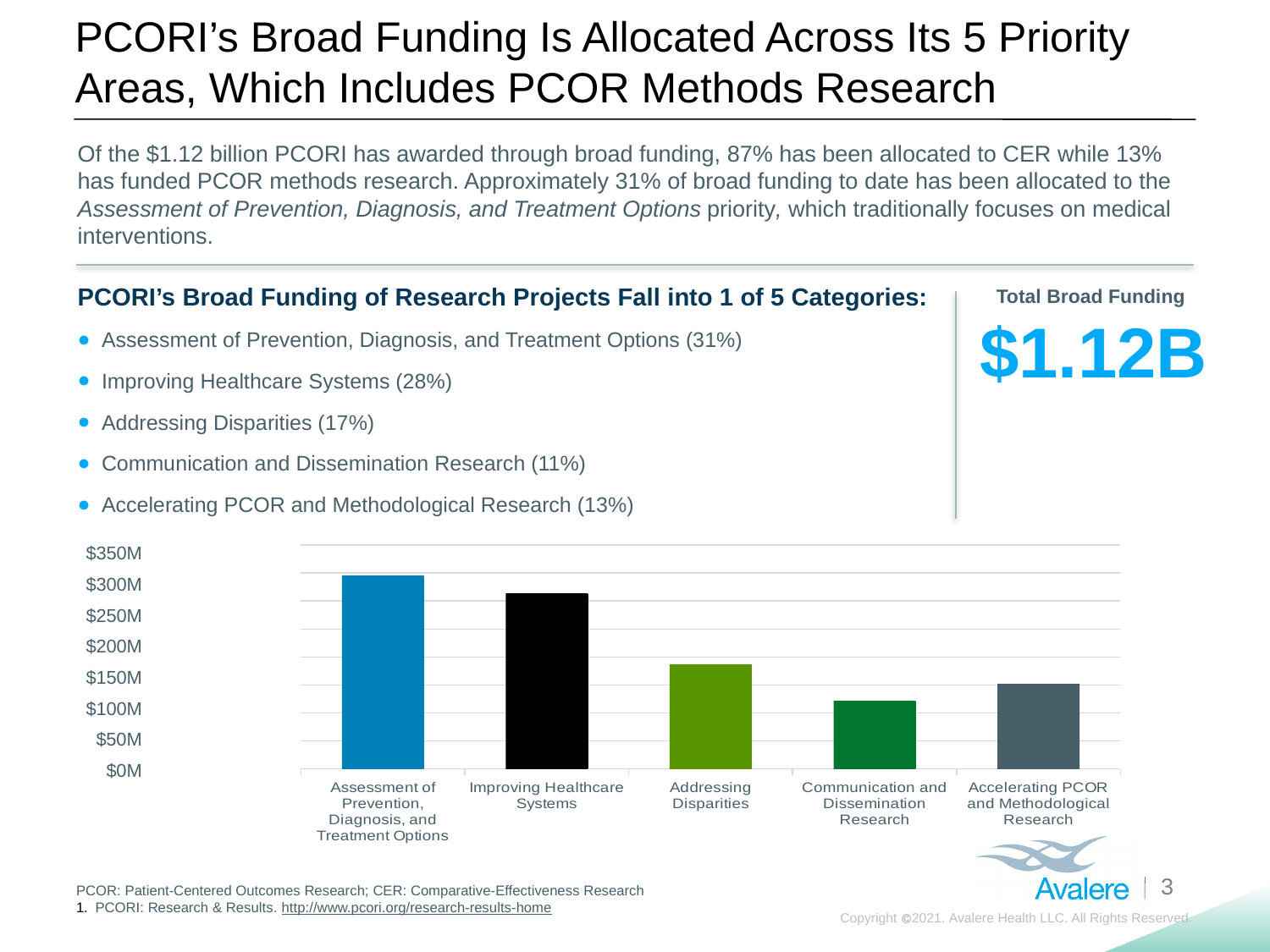
Which category has the shortest bar in the chart? Communication and Dissemination Research What kind of chart is shown on the slide? bar chart What colour is the bar for Assessment of Prevention, Diagnosis, and Treatment Options? blue What is the highest tick label shown on the y axis of the chart? $350M Is the value for Communication and Dissemination Research greater or less than $150M? less Which category has the tallest bar in the chart? Assessment of Prevention, Diagnosis, and Treatment Options Is the value for Accelerating PCOR and Methodological Research greater or less than $100M? greater Which is larger, the bar for Addressing Disparities or the bar for Accelerating PCOR and Methodological Research? Addressing Disparities Is the value for Assessment of Prevention, Diagnosis, and Treatment Options greater or less than $300M? greater How many categories are plotted in the bar chart? 5